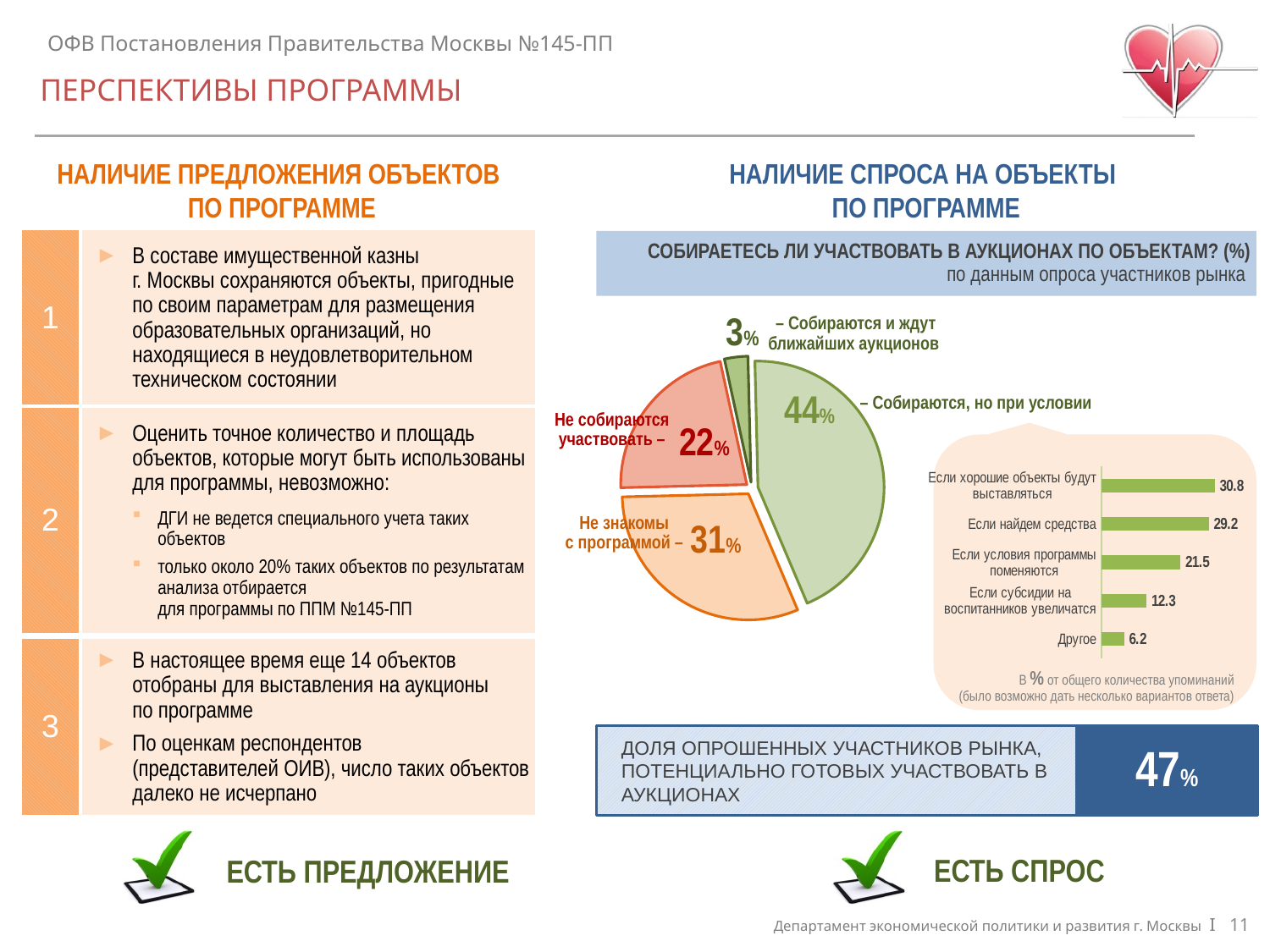
In the horizontal bar chart on the right, what is the difference between 'Если условия программы поменяются' and 'Если субсидии на воспитанников увеличатся'? 9.2 In the pie chart, what share of respondents answered 'Не знакомы с программой'? 31% What type of chart is the one on the right showing conditions such as 'Если найдем средства'? Bar chart In the horizontal bar chart on the right, what is the value for 'Другое'? 6.2 In the pie chart, which answer has the largest share? Собираются, но при условии In the horizontal bar chart on the right, which category has the highest value? Если хорошие объекты будут выставляться In the pie chart, which answer has the smallest share? Собираются и ждут ближайших аукционов In the pie chart, what share of respondents answered 'Не собираются участвовать'? 22% How many slices does the pie chart have? 4 In the horizontal bar chart on the right, what is the value for 'Если найдем средства'? 29.2 In the pie chart 'Собираетесь ли участвовать в аукционах по объектам? (%)', what share of respondents answered 'Собираются, но при условии'? 44% In the pie chart, what is the difference between the shares for 'Не знакомы с программой' and 'Не собираются участвовать'? 9%